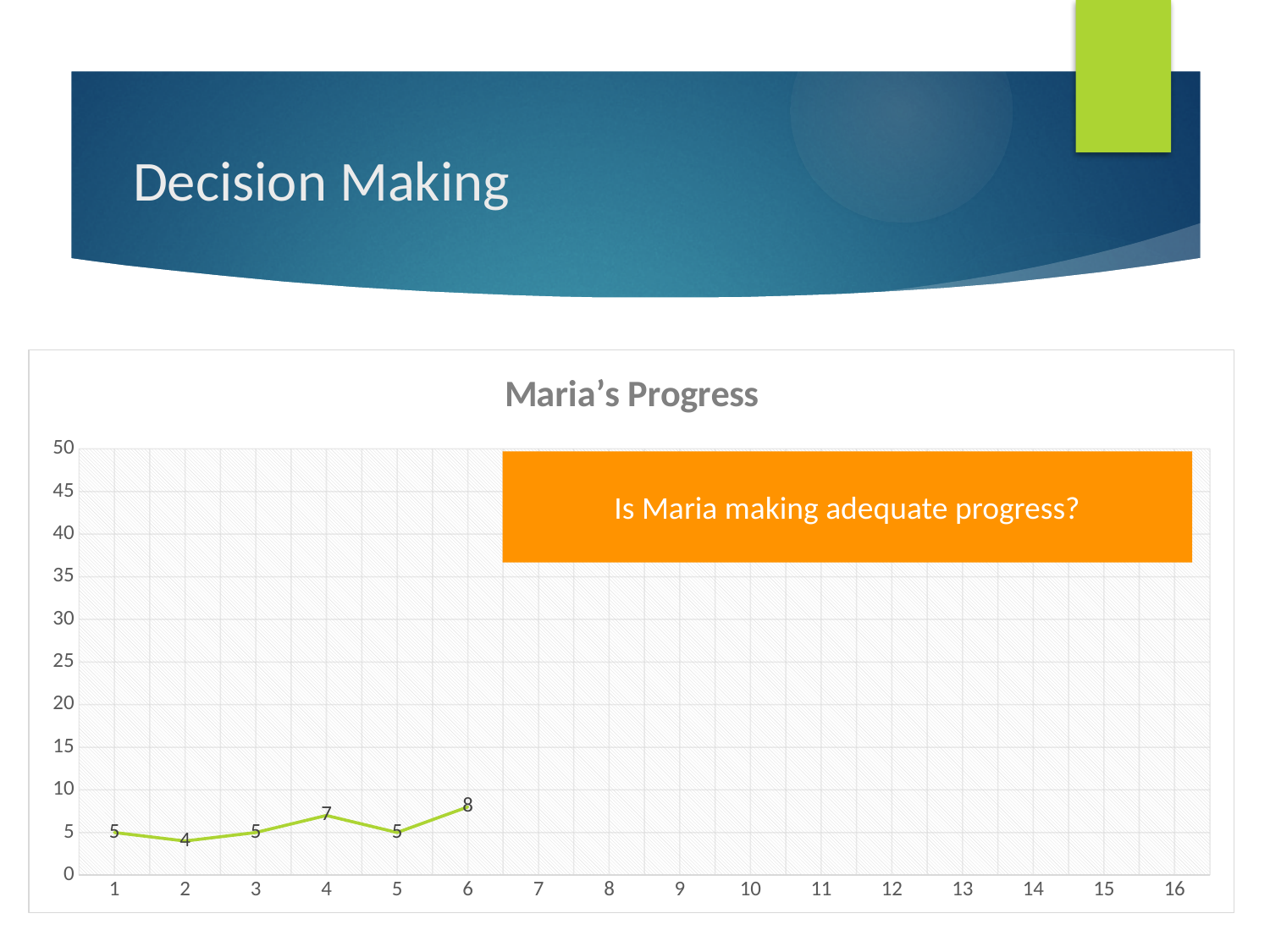
What question is written in the orange box on the chart? Is Maria making adequate progress? What is the difference between the values at point 6 and point 2? 4 What kind of chart is shown on the slide? line chart What is the value at point 4 in Maria's Progress? 7 What is the value at point 6 in Maria's Progress? 8 At which x-axis point is Maria's value highest? 6 At which x-axis point is Maria's value lowest? 2 What is the value at point 1 in Maria's Progress? 5 Which is larger, the value at point 4 or the value at point 5? point 4 Is the value at point 6 greater or less than 10? less How many data points are plotted on the line? 6 What is the title of the chart? Maria's Progress